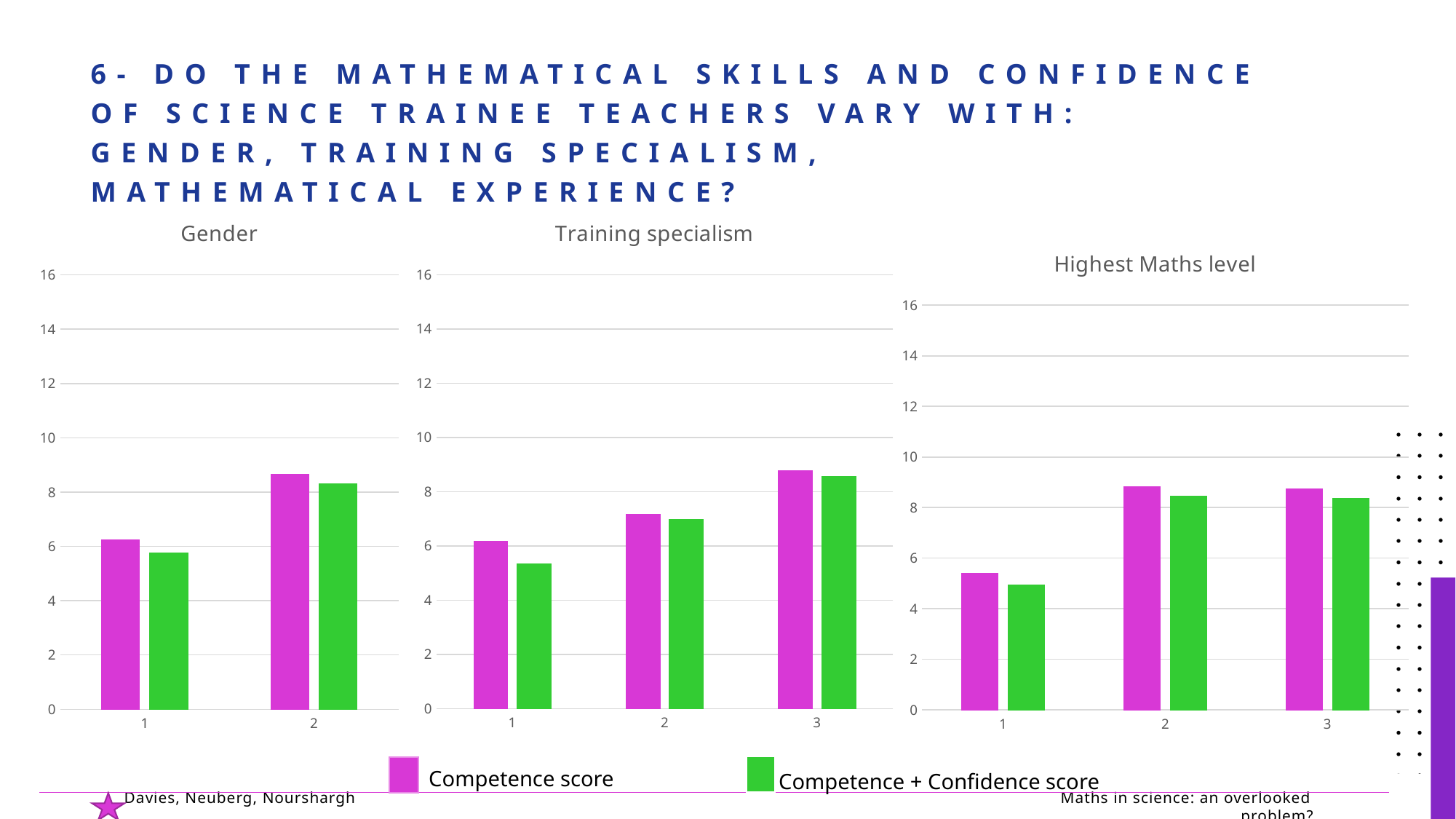
What kind of chart is the Gender chart? bar chart How many series does the legend list for the charts? 2 In the Gender chart, is the Competence + Confidence score for category 1 greater or less than 6? less In the Training specialism chart, which category has the highest Competence score? 3 In the Highest Maths level chart, is the Competence score for category 1 greater or less than 6? less How many categories are shown on the x axis of the Training specialism chart? 3 Which colour represents the Competence + Confidence score in the legend? green In the Gender chart, is the Competence score for category 2 greater or less than 8? greater In the Highest Maths level chart, which category has the lowest Competence + Confidence score? 1 How many categories are shown on the x axis of the Gender chart? 2 In the Training specialism chart, which is larger for category 1: the Competence score or the Competence + Confidence score? Competence score In the Training specialism chart, do the Competence score values rise or fall from category 1 to category 3? rise